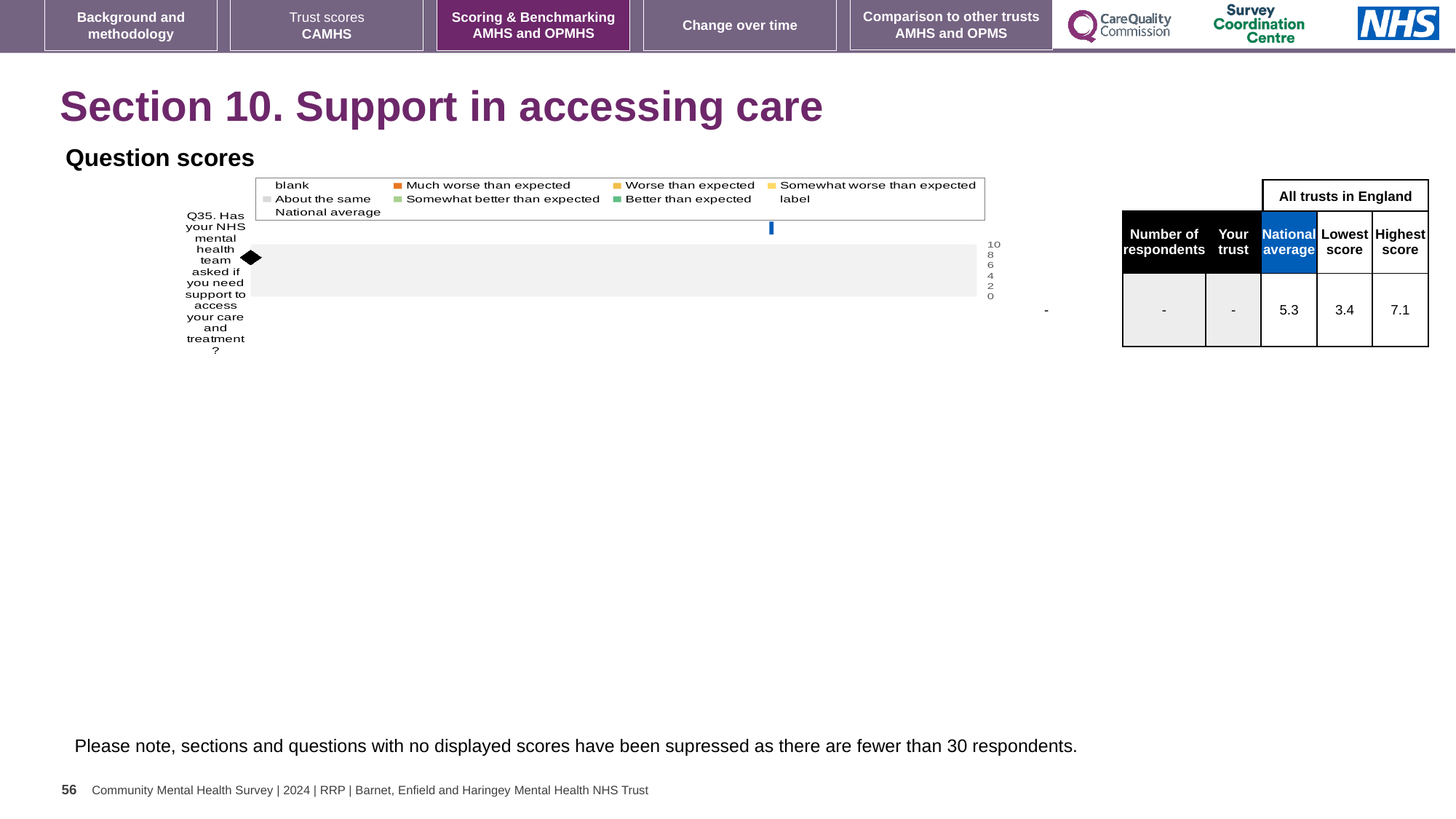
In the table next to the chart, what is the national average score for Q35? 5.3 What kind of chart is shown under 'Question scores'? bar chart How many survey questions are plotted on the chart? 1 In the table next to the chart, what is the highest score among all trusts in England for Q35? 7.1 In the table next to the chart, what is shown as the score for 'Your trust' for Q35? - Which question is plotted on the chart? Q35. Has your NHS mental health team asked if you need support to access your care and treatment? What is the highest value shown on the chart's axis? 10 In the table next to the chart, what is the difference between the highest score and the lowest score for Q35? 3.7 In the table next to the chart, what is the lowest score among all trusts in England for Q35? 3.4 In the table next to the chart, is the national average for Q35 greater or less than 5? greater